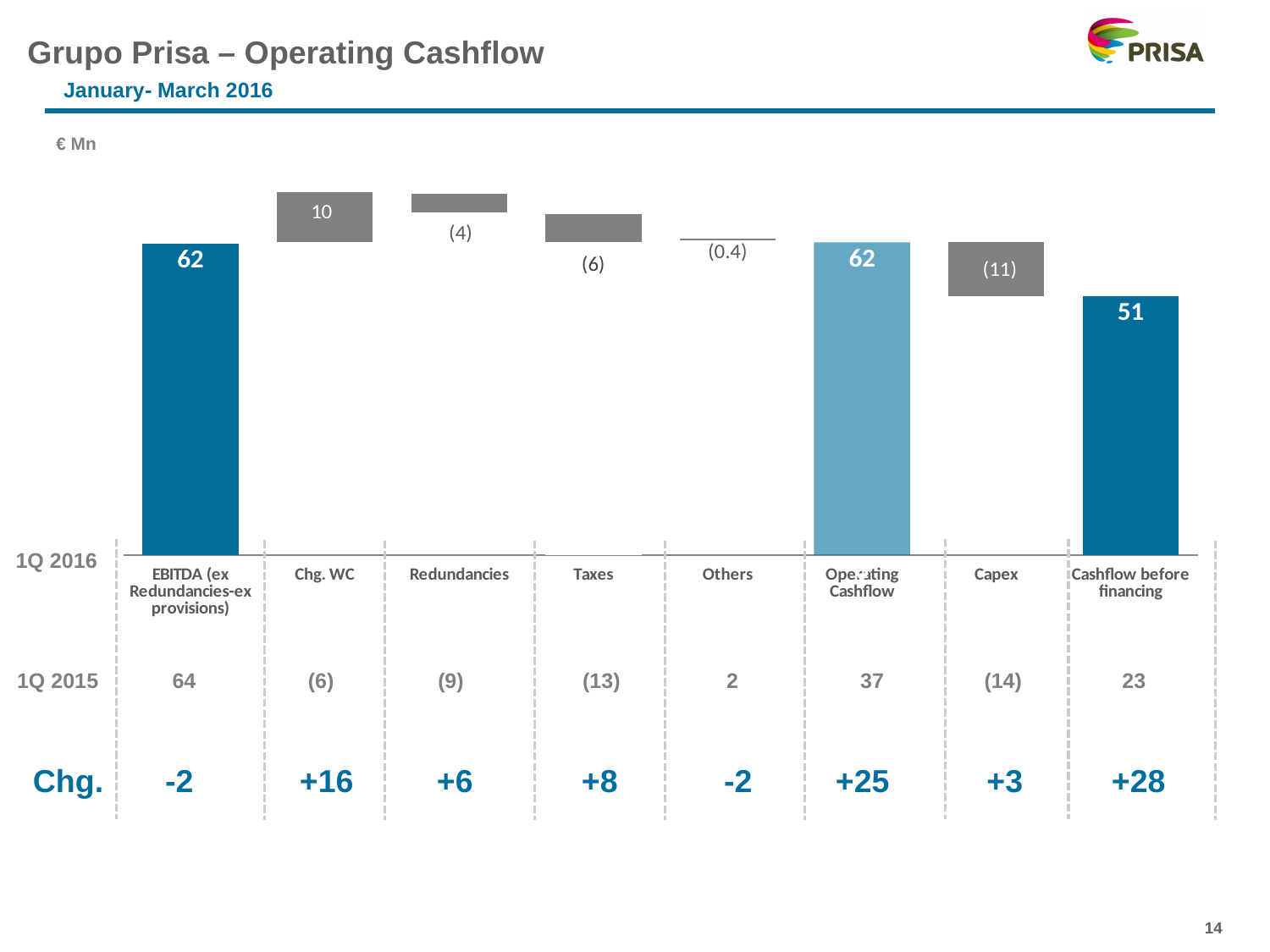
What is the difference between the EBITDA (ex Redundancies-ex provisions) value and the Cashflow before financing value in 1Q 2016? 11 What is the value for Taxes in 1Q 2016? (6) What unit is stated for the values in the chart? € Mn What is the value for Others in 1Q 2016? (0.4) What is the value for Chg. WC in 1Q 2016? 10 How many categories are shown along the x axis of the chart? 8 What is the value for Cashflow before financing in 1Q 2016? 51 What is the value for EBITDA (ex Redundancies-ex provisions) in 1Q 2016? 62 What is the value for Capex in 1Q 2016? (11) What kind of chart is shown on the slide? bar chart Which is larger in 1Q 2016, the Operating Cashflow value or the Cashflow before financing value? Operating Cashflow Which category has the lowest (most negative) value in 1Q 2016? Capex